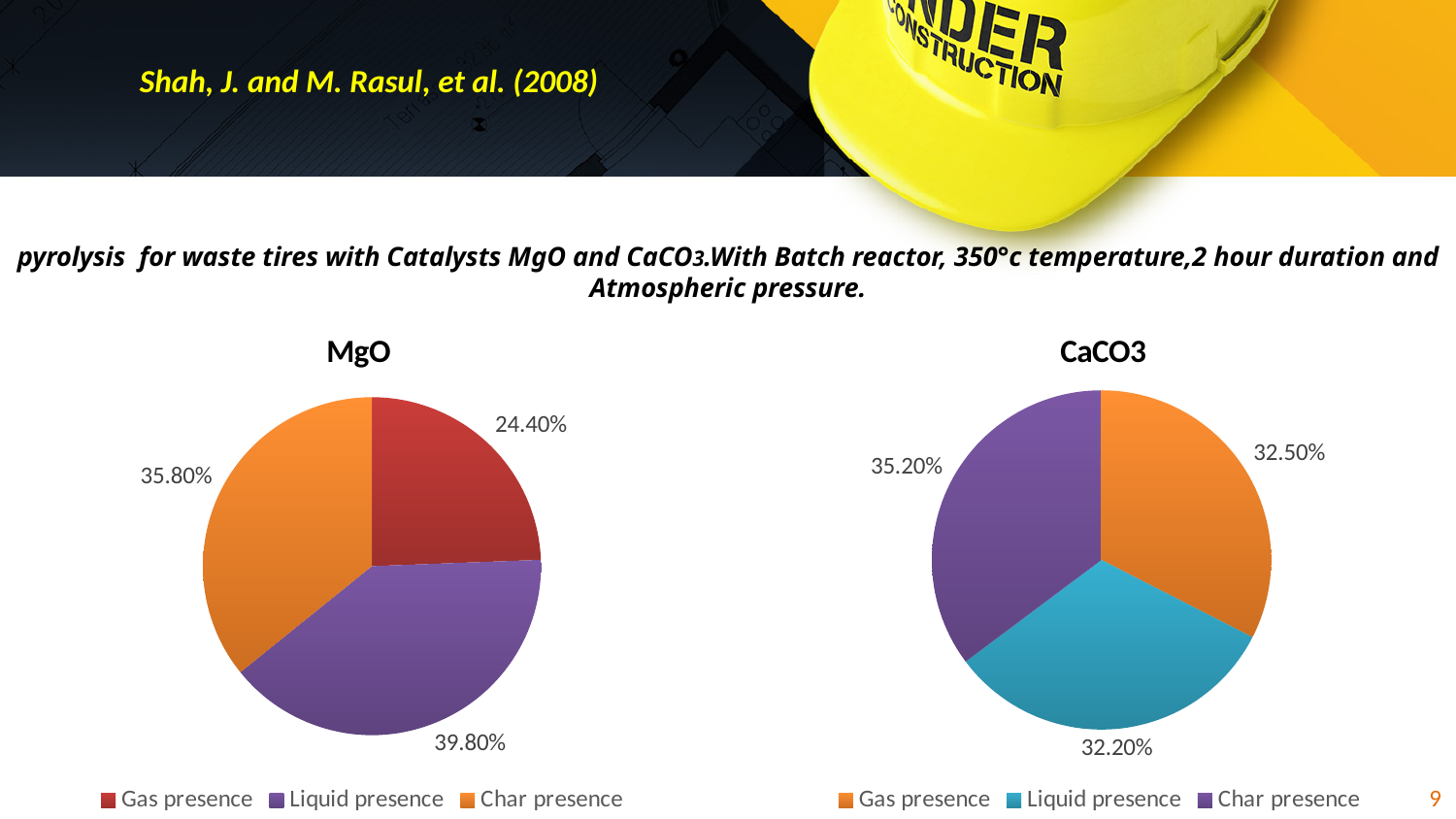
In the MgO chart, what is the value for Gas presence? 24.40% In the CaCO3 chart, what is the value for Char presence? 35.20% In the MgO chart, which category has the smallest share? Gas presence How many entries does the legend of the MgO chart list? 3 In the CaCO3 chart, what is the value for Gas presence? 32.50% What kind of chart is the CaCO3 chart? Pie chart In the MgO chart, what is the difference between Liquid presence and Gas presence? 15.40% In the CaCO3 chart, which category has the largest share? Char presence In the MgO chart, which category has the largest share? Liquid presence In the MgO chart, what is the value for Liquid presence? 39.80% In the MgO chart, which is larger, Char presence or Gas presence? Char presence In the CaCO3 chart, what is the difference between Char presence and Liquid presence? 3.00%